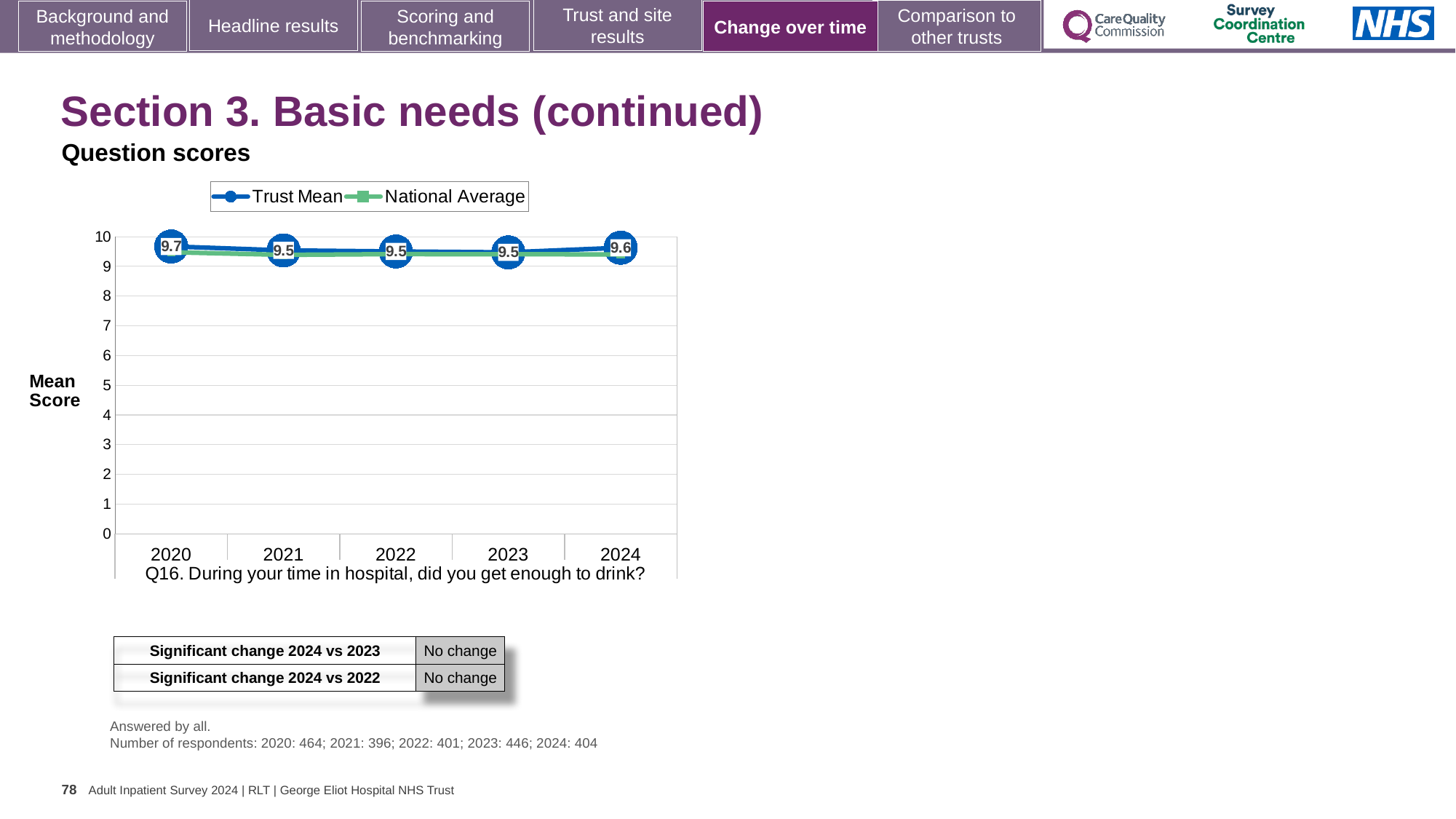
In which year is the Trust Mean score highest? 2020 What is the label on the y axis of the chart? Mean Score Does the Trust Mean score rise or fall from 2020 to 2021? Fall How many series does the chart legend list? 2 What is the difference between the Trust Mean score in 2020 and in 2024? 0.1 Which year has the larger Trust Mean score, 2020 or 2021? 2020 What kind of chart is shown on the slide? Line chart What is the Trust Mean score for 2022? 9.5 What is the Trust Mean score for 2024? 9.6 Is the National Average value for 2022 greater or less than 9? greater How many years are shown on the x axis of the chart? 5 What is the Trust Mean score for 2020? 9.7